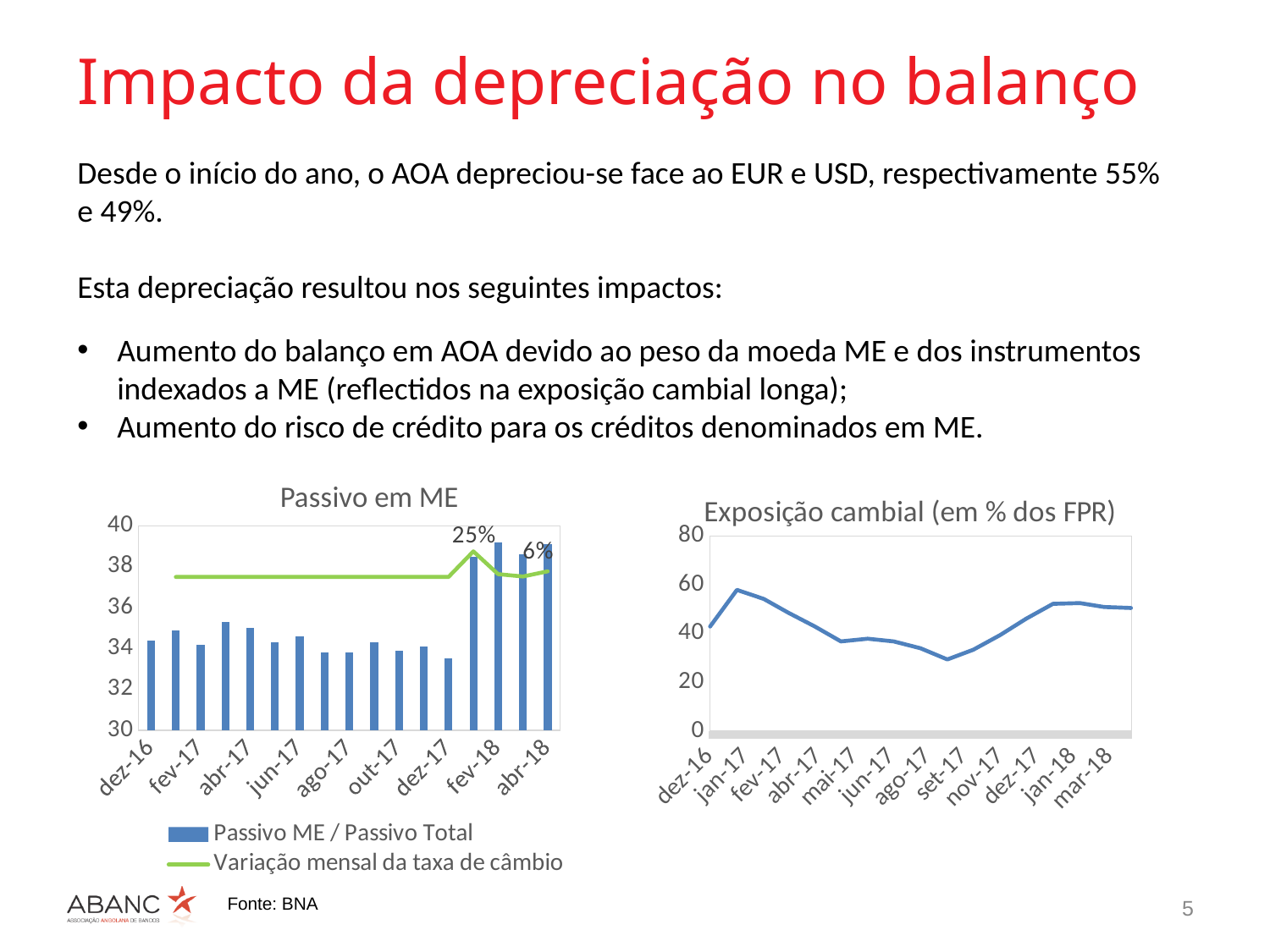
In the 'Passivo em ME' chart, which labelled month has the shortest 'Passivo ME / Passivo Total' bar? dez-17 In the 'Passivo em ME' chart, how many series does the legend list? 2 What kind of chart is the 'Exposição cambial (em % dos FPR)' chart on the right? Line chart In the 'Exposição cambial (em % dos FPR)' chart, is the value for set-17 greater or less than 40? less In the 'Passivo em ME' chart, which month has the tallest 'Passivo ME / Passivo Total' bar? fev-18 In the 'Exposição cambial (em % dos FPR)' chart, which month has the highest value? jan-17 In the 'Passivo em ME' chart, is the 'Passivo ME / Passivo Total' bar for dez-16 greater or less than 36? less What kind of chart is the 'Passivo em ME' chart on the left? A combination bar and line chart In the 'Exposição cambial (em % dos FPR)' chart, which month has the lowest value? set-17 In the 'Passivo em ME' chart, what is the highest labelled value on the 'Variação mensal da taxa de câmbio' line? 25% In the 'Passivo em ME' chart, what are the two legend entries? Passivo ME / Passivo Total; Variação mensal da taxa de câmbio In the 'Passivo em ME' chart, is the 'Passivo ME / Passivo Total' bar for fev-18 greater or less than 38? greater